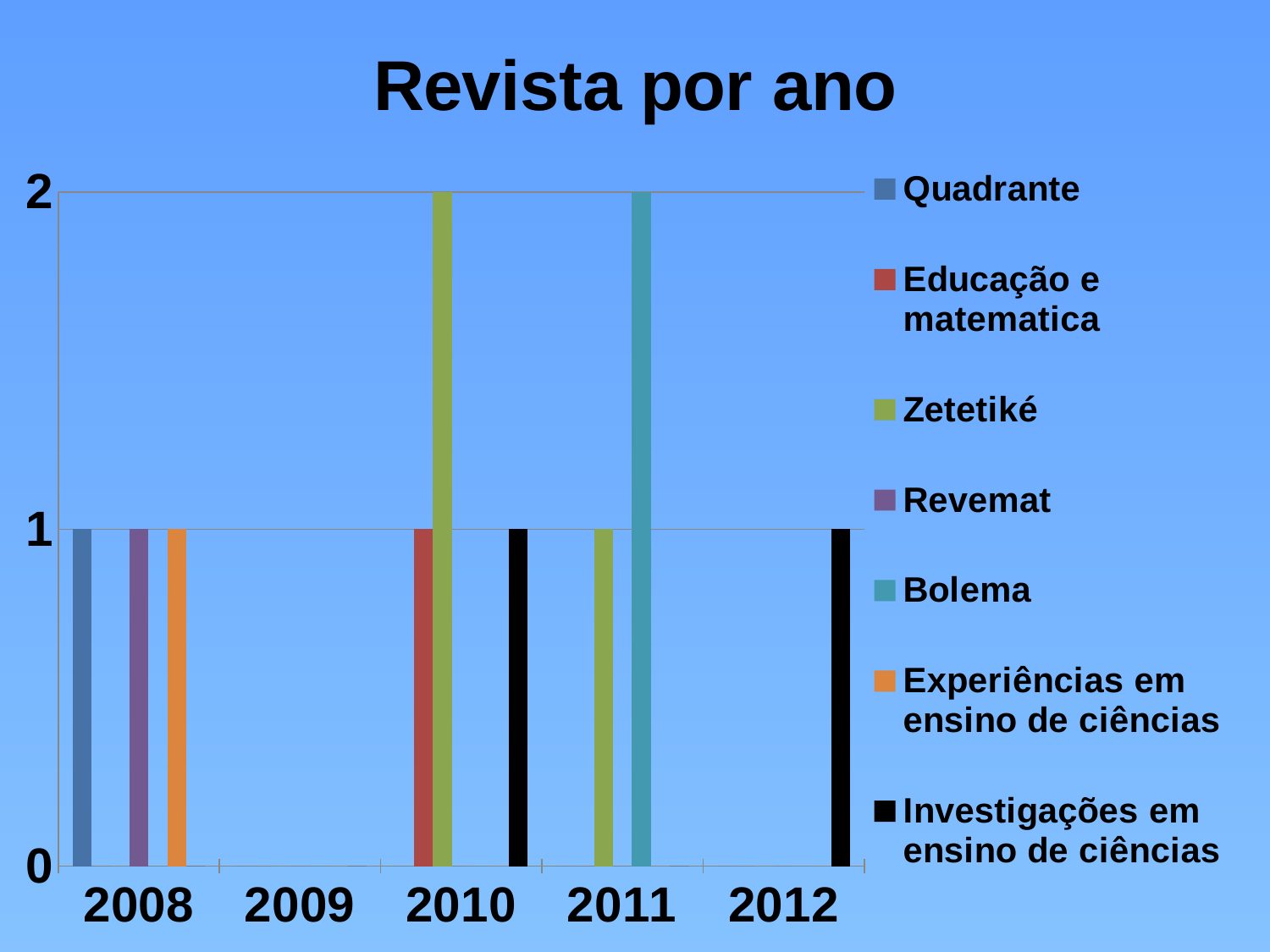
What is the title of the chart? Revista por ano What is the value for Bolema in 2011? 2 How many years are shown on the x axis? 5 What is the value for Zetetiké in 2010? 2 What kind of chart is shown on the slide? bar chart Which series has the highest value in 2011? Bolema Which is larger: the value for Bolema in 2011 or the value for Educação e matematica in 2010? Bolema in 2011 What is the difference between the value for Zetetiké in 2010 and the value for Zetetiké in 2011? 1 How many series does the legend list? 7 What is the value for Investigações em ensino de ciências in 2012? 1 What is the value for Quadrante in 2008? 1 Which year has no bars at all? 2009